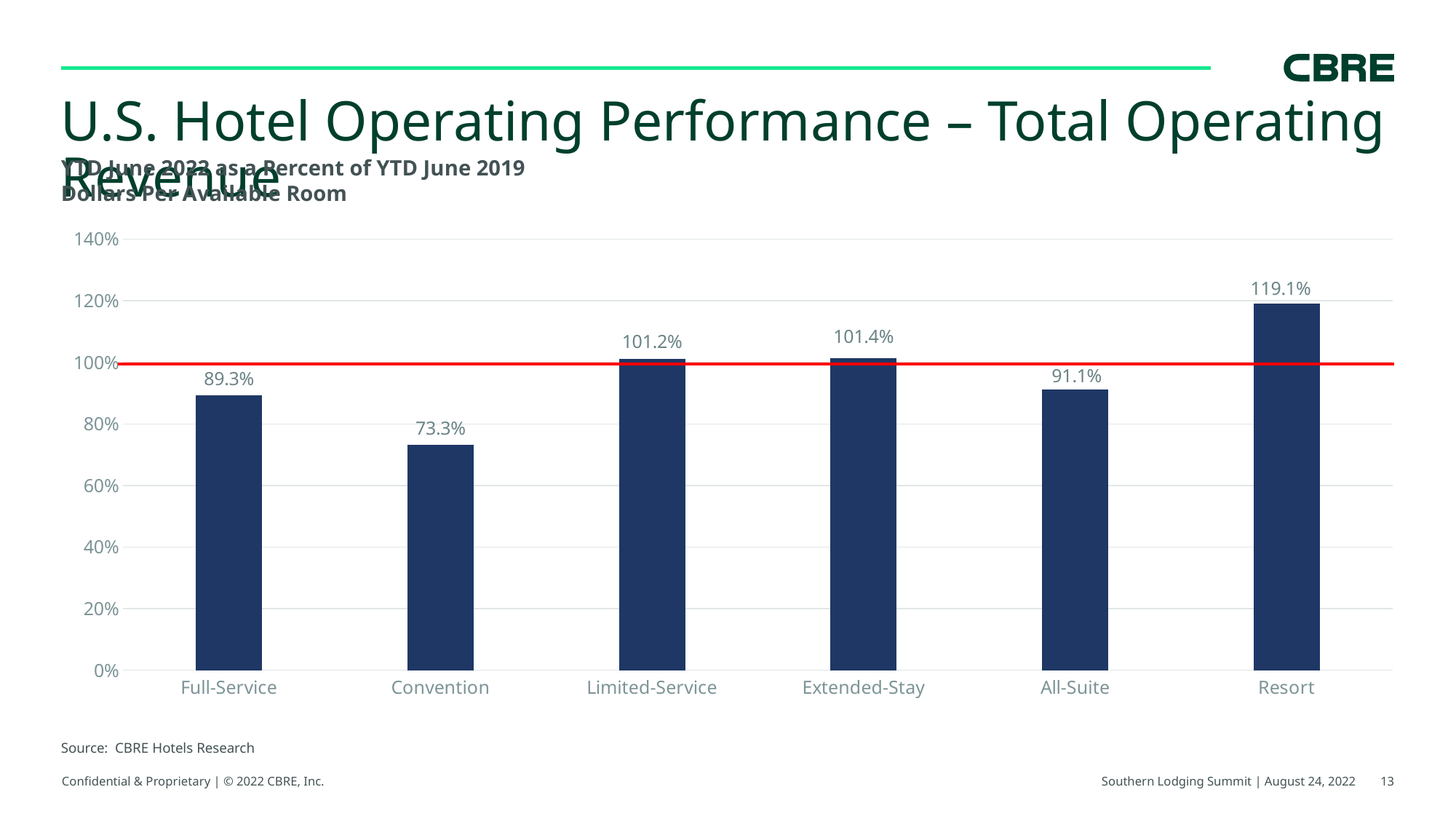
What kind of chart is shown on the slide? Bar chart Which is larger, the value for All-Suite or the value for Full-Service? All-Suite Which category has the lowest value? Convention What is the difference between the values for Resort and Convention? 45.8% What is the value for Full-Service? 89.3% What is the value for Resort? 119.1% At what level is the horizontal red line drawn on the chart? 100% Which category has the highest value? Resort What is the difference between the values for All-Suite and Full-Service? 1.8% What is the value for Convention? 73.3% How many categories are shown on the x axis? 6 What is the value for Extended-Stay? 101.4%